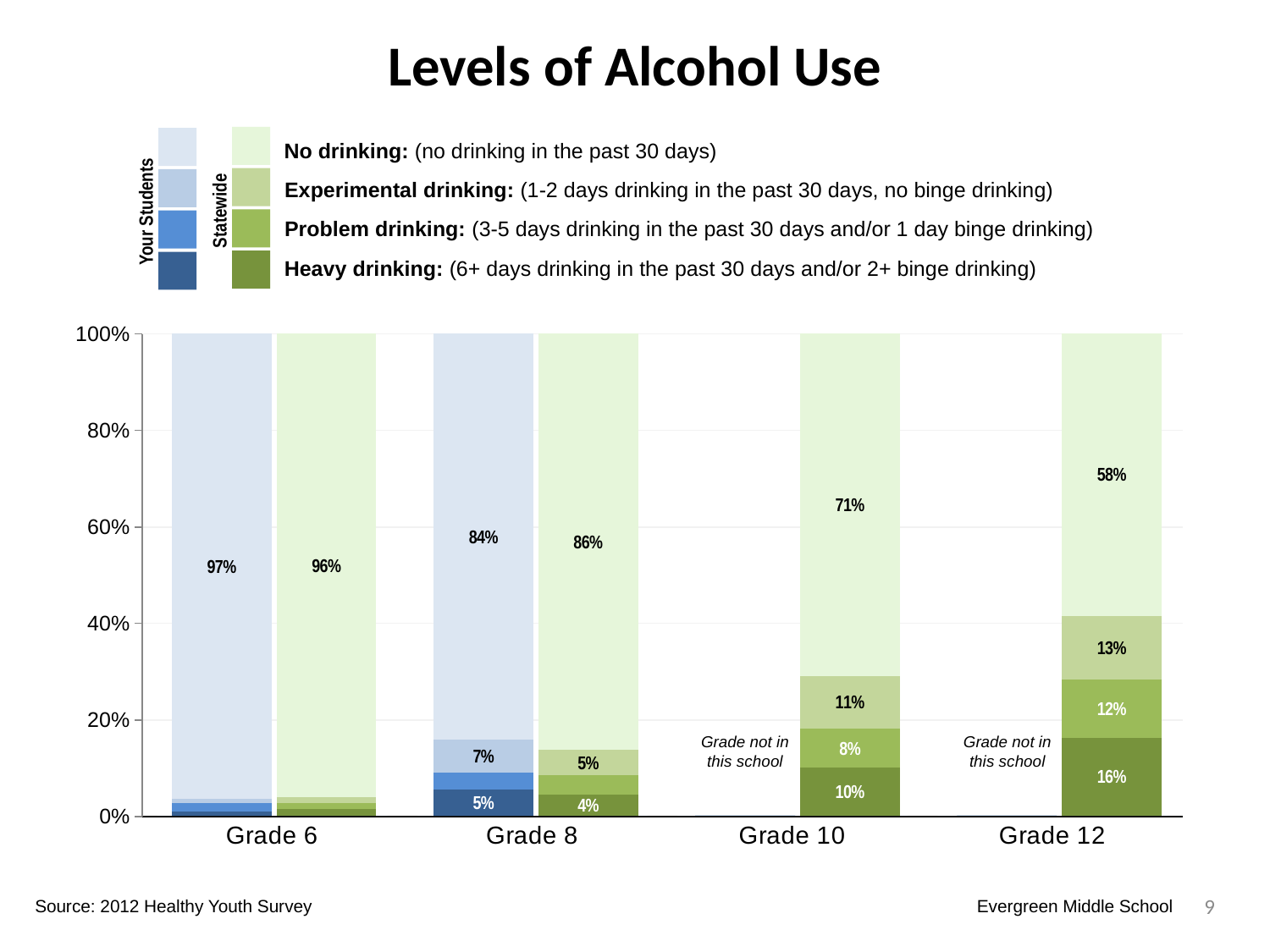
How many grade categories are shown on the x axis? 4 Which grade has the highest Statewide percentage for Heavy drinking? Grade 12 In Grade 6, which is larger for No drinking: Your Students or Statewide? Your Students What is the Statewide percentage for Experimental drinking in Grade 12? 13% What is the Statewide percentage for No drinking in Grade 12? 58% What text appears in place of the Your Students bar for Grade 10? Grade not in this school What is the Statewide percentage for Heavy drinking in Grade 10? 10% Does the Statewide No drinking percentage rise or fall from Grade 6 to Grade 12? Fall What is the Your Students percentage for Heavy drinking in Grade 8? 5% In Grade 8, how many percentage points higher is the Statewide No drinking value than the Your Students No drinking value? 2 What is the Your Students percentage for No drinking in Grade 8? 84% What kind of chart is shown on the slide? Stacked bar chart